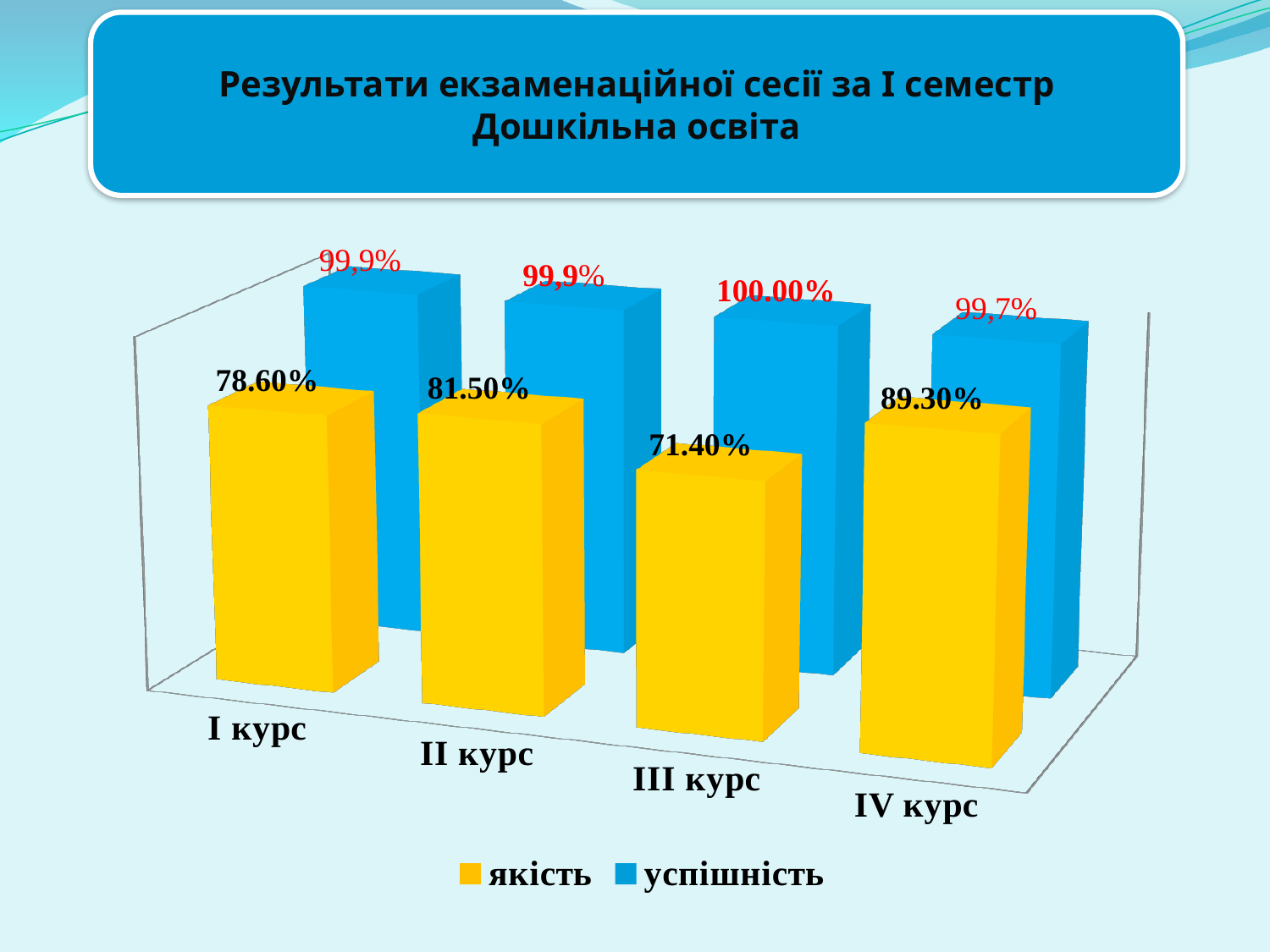
How many courses are shown on the x axis? 4 What is the якість value for I курс? 78.60% How many series does the legend list? 2 What is the якість value for IV курс? 89.30% Which series is shown in yellow according to the legend? якість What is the difference between the якість values for IV курс and III курс? 17.90% Which course has the highest якість value? IV курс What kind of chart is shown on the slide? Bar chart Which has a higher якість value, I курс or II курс? II курс Which course has the lowest якість value? III курс What is the успішність value for III курс? 100.00% What is the успішність value for IV курс? 99,7%